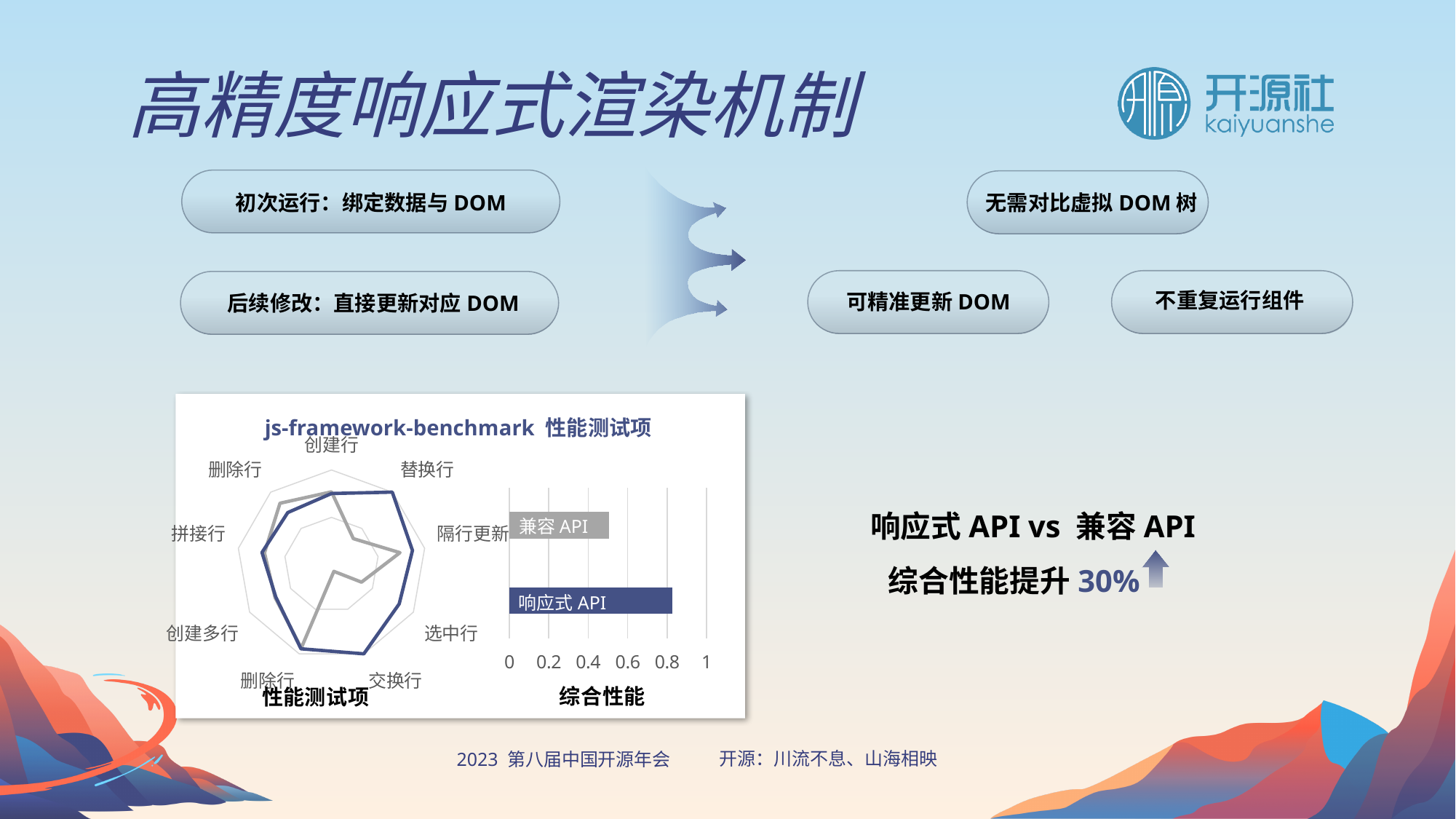
What kind of chart is the chart on the left labelled 性能测试项? radar chart What is the maximum tick value shown on the x axis of the 综合性能 bar chart? 1 In the 综合性能 bar chart, is the value for 响应式 API greater or less than 0.6? greater What is the title printed above the 性能测试项 radar chart? js-framework-benchmark 性能测试项 In the 综合性能 bar chart, is the value for 兼容 API greater or less than 0.6? less In the 综合性能 bar chart, which category has the highest value? 响应式 API In the 综合性能 bar chart, which of the two bars is longer, 兼容 API or 响应式 API? 响应式 API How many bars are shown in the 综合性能 bar chart? 2 In the 综合性能 bar chart, which category has the lowest value? 兼容 API What kind of chart is the chart on the right labelled 综合性能? bar chart How many axes (test items) does the 性能测试项 radar chart have? 9 In the 综合性能 bar chart, is the value for 兼容 API greater or less than 0.4? greater